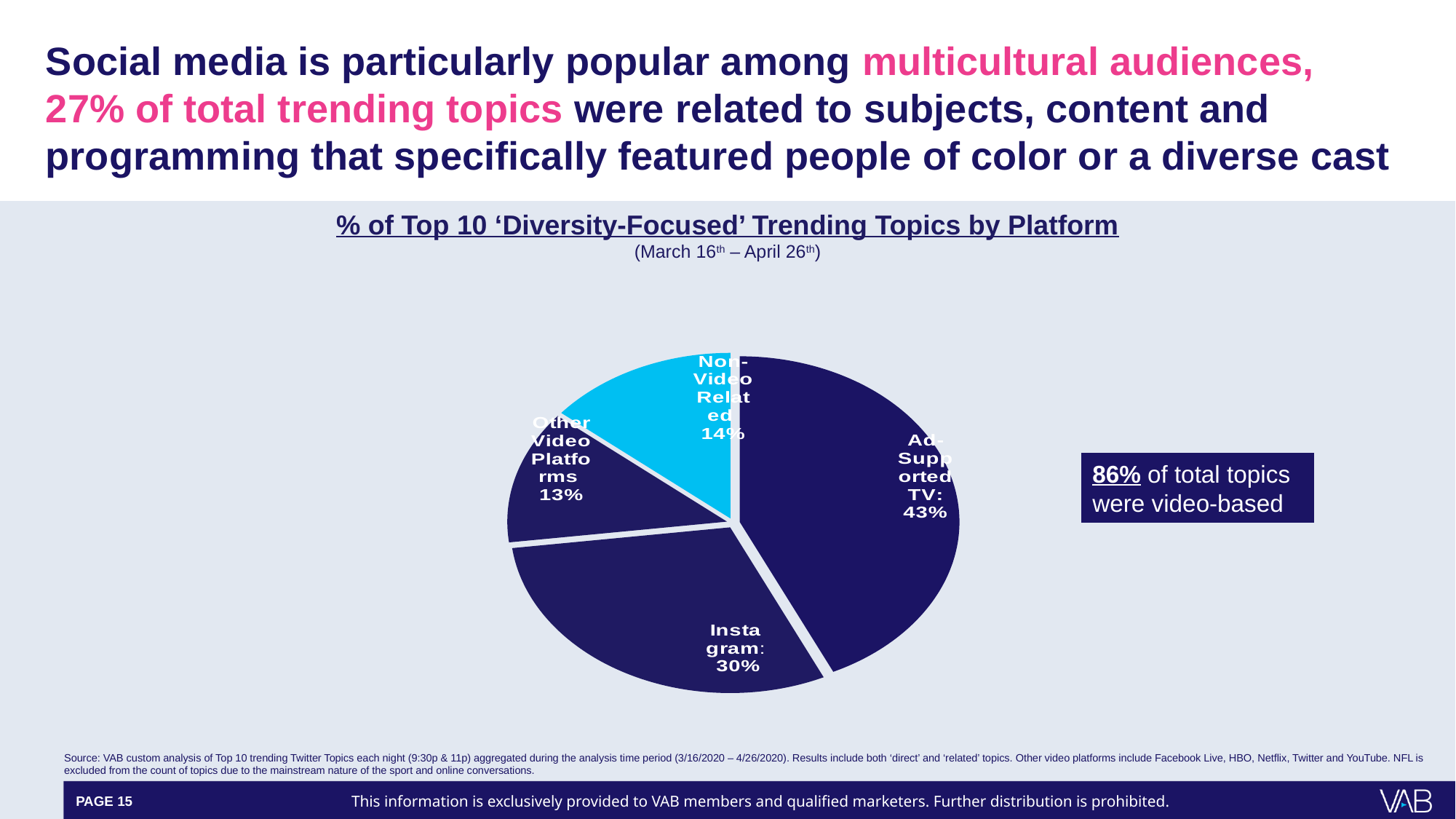
What share of the pie is Ad-Supported TV? 43% What type of chart is shown on the slide? Pie chart What is the title of the chart? % of Top 10 'Diversity-Focused' Trending Topics by Platform Which slice of the pie chart is the smallest? Other Video Platforms Which slice of the pie chart is shown in light blue? Non-Video Related What share of the pie is Non-Video Related? 14% How many slices does the pie chart have? 4 What share of the pie is Instagram? 30% What is the difference in percentage points between Ad-Supported TV and Instagram? 13 Which slice of the pie chart is the largest? Ad-Supported TV Which is larger, the Instagram slice or the Non-Video Related slice? Instagram